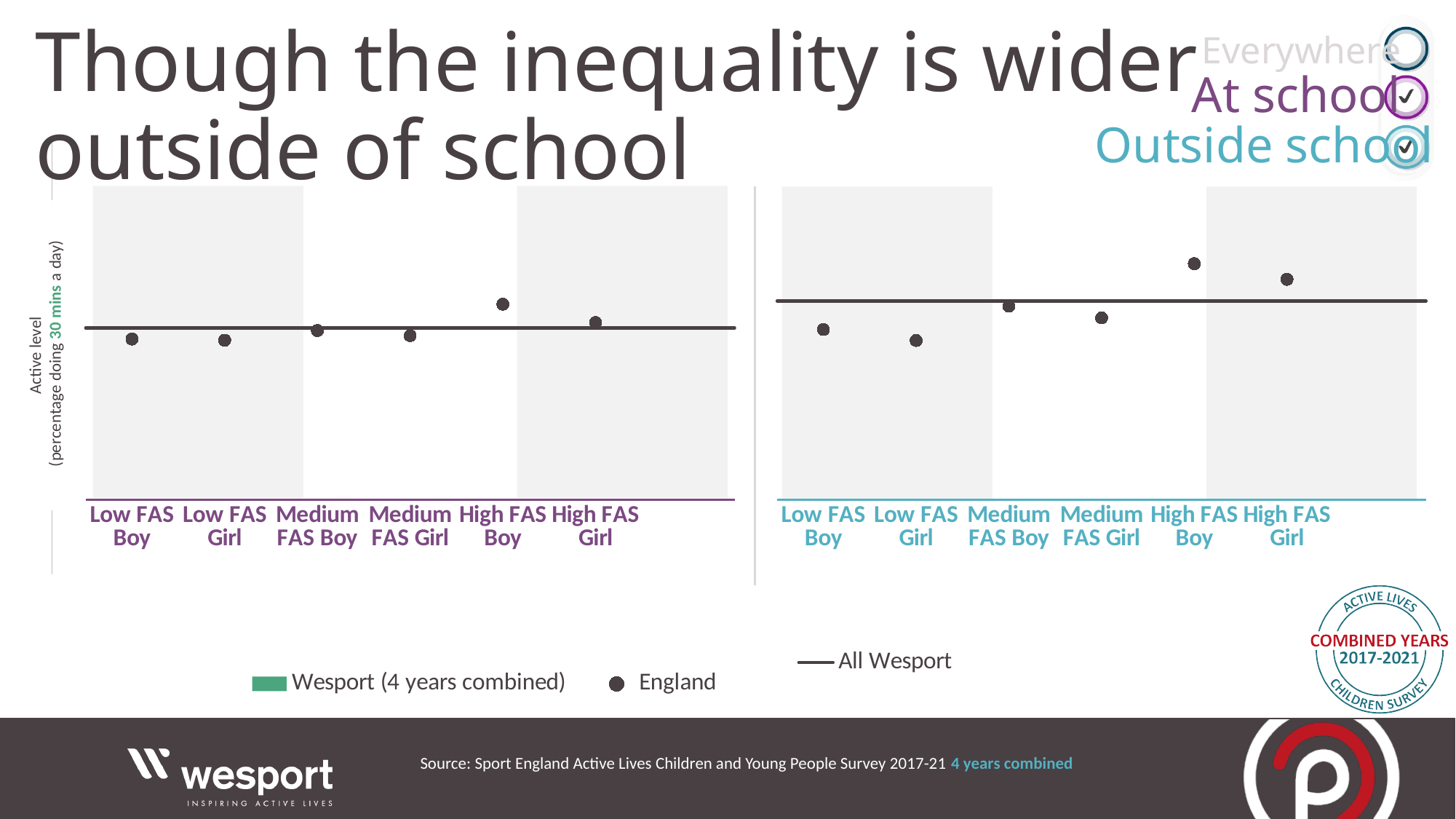
In the left (At school) chart, which category has the highest England dot? High FAS Boy In the right (Outside school) chart, is the England dot higher for Low FAS Boy or Low FAS Girl? Low FAS Boy What does the y axis of the charts measure, according to its label? Active level (percentage doing 30 mins a day) In the right (Outside school) chart, do the England dots generally rise or fall moving from Low FAS to High FAS along the x axis? rise In the right (Outside school) chart, which category has the highest England dot? High FAS Boy How many series does the legend at the bottom of the slide list? 3 In the left (At school) chart, is the England dot higher for High FAS Boy or Medium FAS Boy? High FAS Boy How many categories are shown on the x axis of the left (At school) chart? 6 In the right (Outside school) chart, is the England dot higher for Medium FAS Boy or Medium FAS Girl? Medium FAS Boy How many categories are shown on the x axis of the right (Outside school) chart? 6 In the right (Outside school) chart, which category has the lowest England dot? Low FAS Girl Which legend entry is represented by a horizontal line in the charts? All Wesport